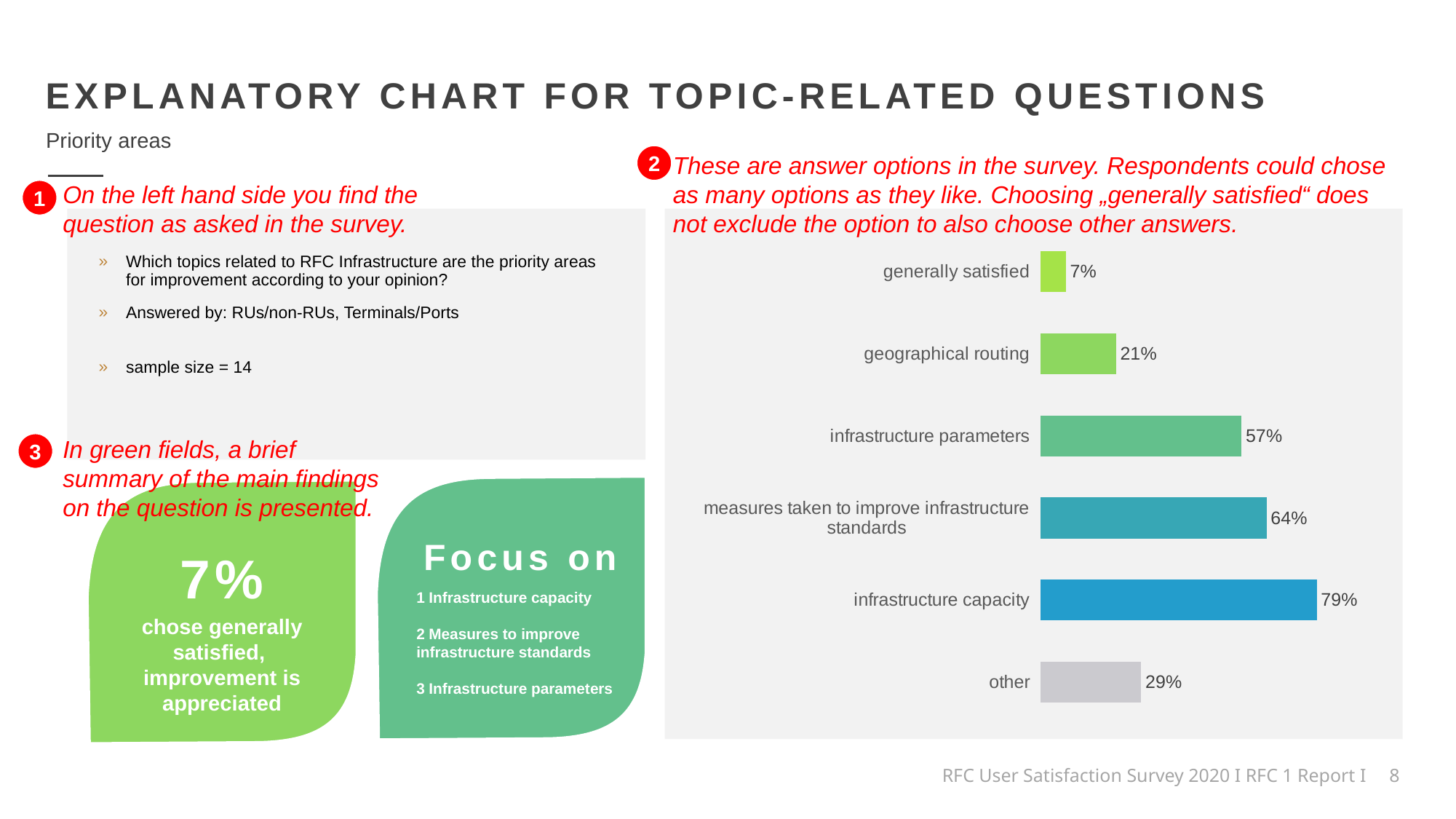
Which is larger: the value for "other" or the value for "geographical routing"? other What percentage of respondents chose "infrastructure capacity"? 79% Which category has the lowest value in the chart? generally satisfied What is the value shown for "geographical routing"? 21% What percentage is shown for "measures taken to improve infrastructure standards"? 64% Which category has the highest value in the chart? infrastructure capacity How many categories are shown in the bar chart? 6 What colour is the bar for the "other" category? grey What is the value for the "other" category? 29% What is the difference between the values for "infrastructure capacity" and "infrastructure parameters"? 22% What type of chart is shown on the right side of the slide? bar chart What is the difference between the values for "measures taken to improve infrastructure standards" and "generally satisfied"? 57%